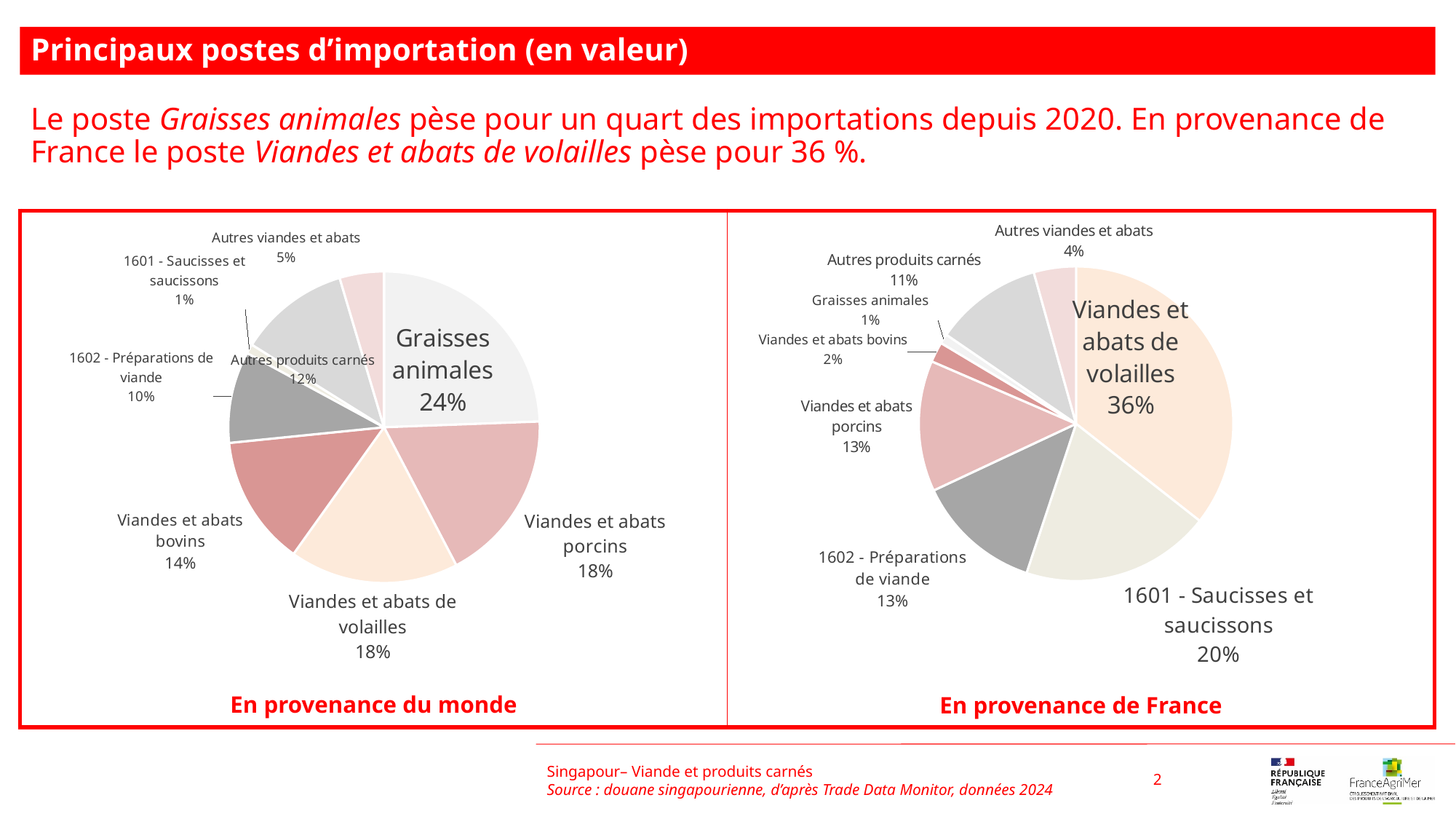
In the 'En provenance de France' pie chart, what share does Viandes et abats de volailles have? 36% In the 'En provenance de France' pie chart, which category has the smallest share? Graisses animales How many categories are shown in the 'En provenance du monde' pie chart? 8 In the 'En provenance du monde' pie chart, which category has the smallest share? 1601 - Saucisses et saucissons In the 'En provenance du monde' pie chart, what is the difference in percentage points between Graisses animales and Viandes et abats bovins? 10 In the 'En provenance de France' pie chart, which is larger: Viandes et abats porcins or Autres produits carnés? Viandes et abats porcins In the 'En provenance du monde' pie chart, what share does Graisses animales have? 24% In the 'En provenance du monde' pie chart, what share does Autres produits carnés have? 12% In the 'En provenance de France' pie chart, what is the difference in percentage points between Viandes et abats de volailles and 1601 - Saucisses et saucissons? 16 What type of chart is used for 'En provenance de France'? Pie chart In the 'En provenance du monde' pie chart, which category has the largest share? Graisses animales In the 'En provenance de France' pie chart, what is the share of 1601 - Saucisses et saucissons? 20%